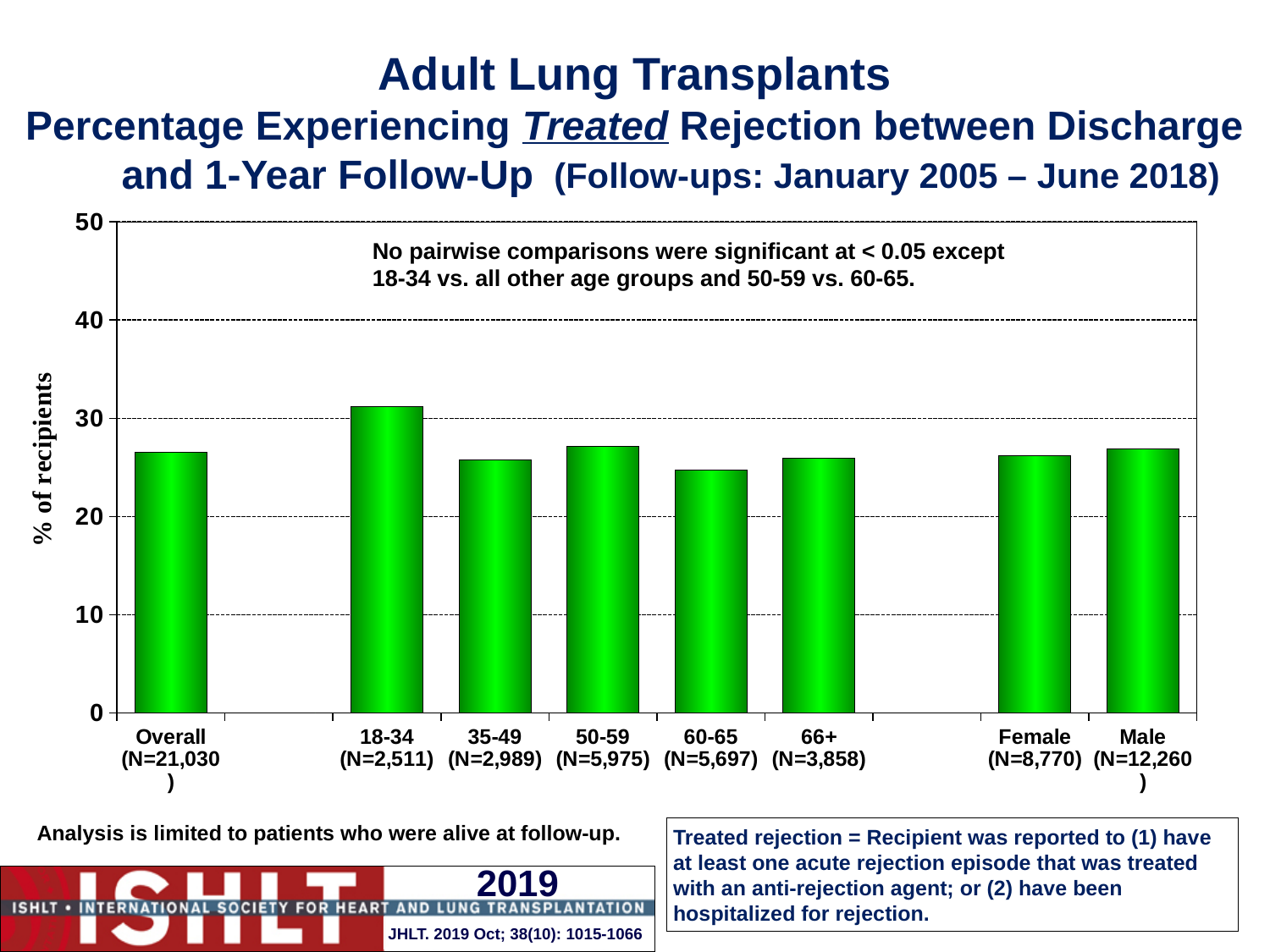
Which category has the lowest percentage of recipients experiencing treated rejection? 60-65 Is the value for the 18-34 age group greater or less than 30? greater Which category has the highest percentage of recipients experiencing treated rejection? 18-34 How many bars (categories) are plotted in the chart? 8 Which is larger, the value for 50-59 or the value for 60-65? 50-59 Is the value for Overall greater or less than 20? greater What is the label on the y-axis of the chart? % of recipients What kind of chart is shown on the slide? bar chart Is the value for the 60-65 age group greater or less than 30? less What is the N shown for the Overall category? N=21,030 Which is larger, the value for 18-34 or the value for 50-59? 18-34